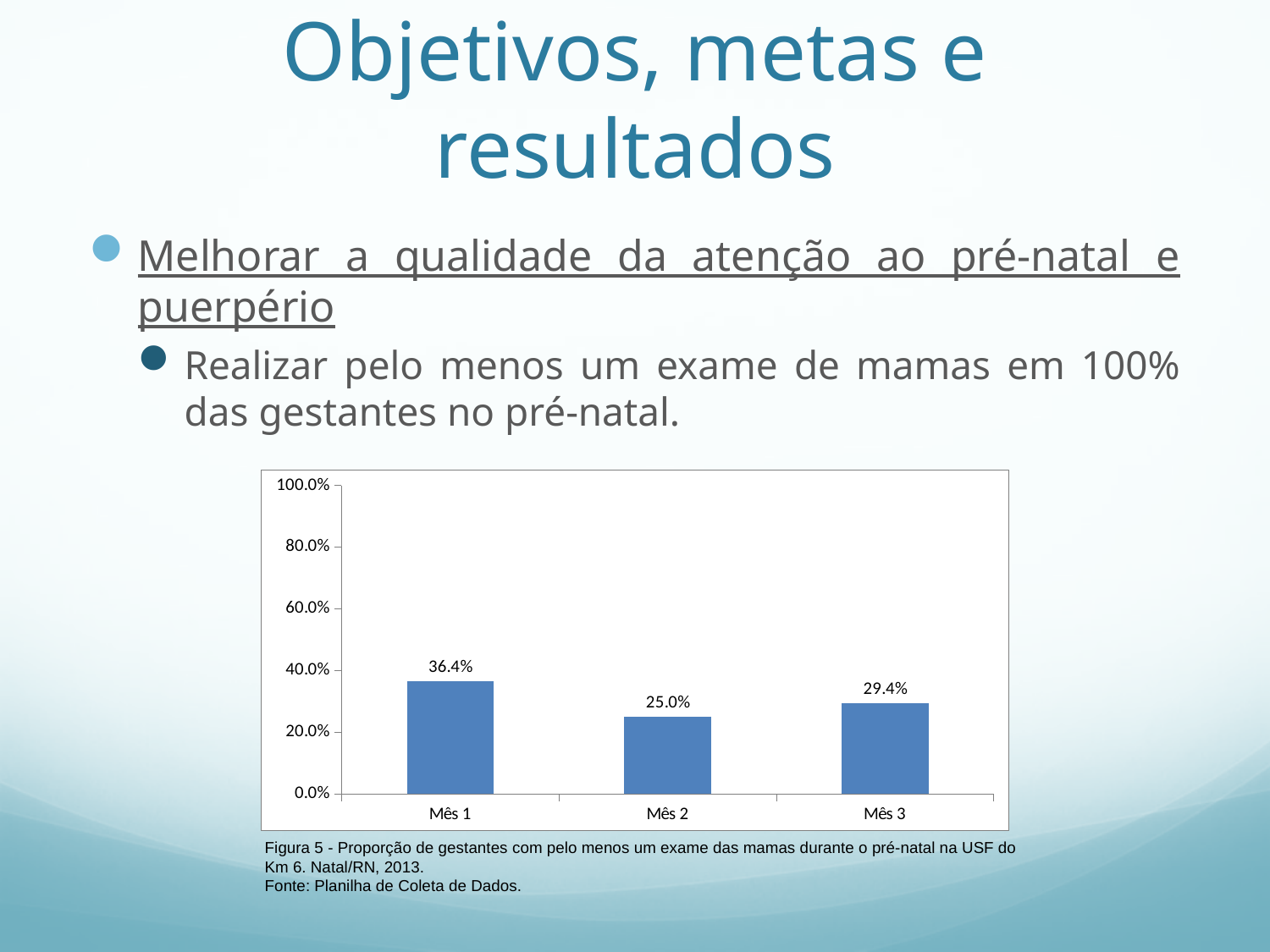
Is the value for Mês 1 greater or less than 40.0%? less How many months are shown on the x axis? 3 What is the difference between the values for Mês 3 and Mês 2? 4.4% What is the difference between the values for Mês 1 and Mês 2? 11.4% What is the value for Mês 2? 25.0% Which month has the highest value? Mês 1 What is the highest value shown on the y axis? 100.0% Which is larger, the value for Mês 1 or the value for Mês 3? Mês 1 What kind of chart is shown on the slide? bar chart What is the value for Mês 3? 29.4% Which month has the lowest value? Mês 2 What is the value for Mês 1? 36.4%